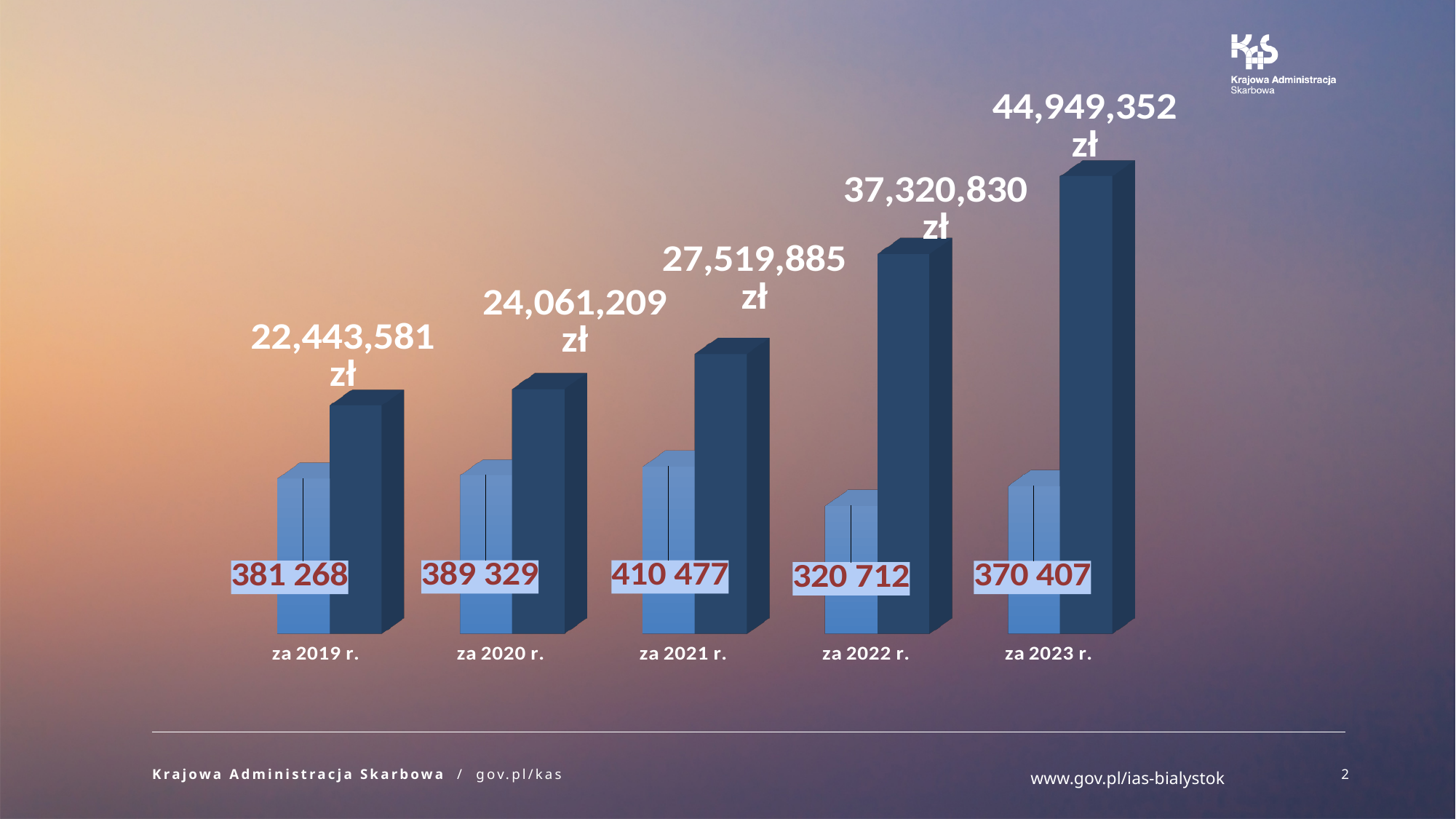
What kind of chart is shown on the slide? bar chart What is the value of the light blue bar for za 2022 r.? 320 712 Which year has the highest value for the dark blue bars? za 2023 r. Which year has the lowest value for the light blue bars? za 2022 r. What is the value of the dark blue bar for za 2019 r.? 22,443,581 zł Which year has the highest value for the light blue bars? za 2021 r. Which is larger, the light blue value for za 2019 r. or for za 2020 r.? za 2020 r. What is the value of the dark blue bar for za 2021 r.? 27,519,885 zł What is the difference between the light blue values for za 2021 r. and za 2022 r.? 89 765 How many year categories are shown on the chart? 5 Do the dark blue bar values rise or fall from za 2019 r. to za 2023 r.? rise What is the difference between the dark blue values for za 2023 r. and za 2022 r.? 7,628,522 zł